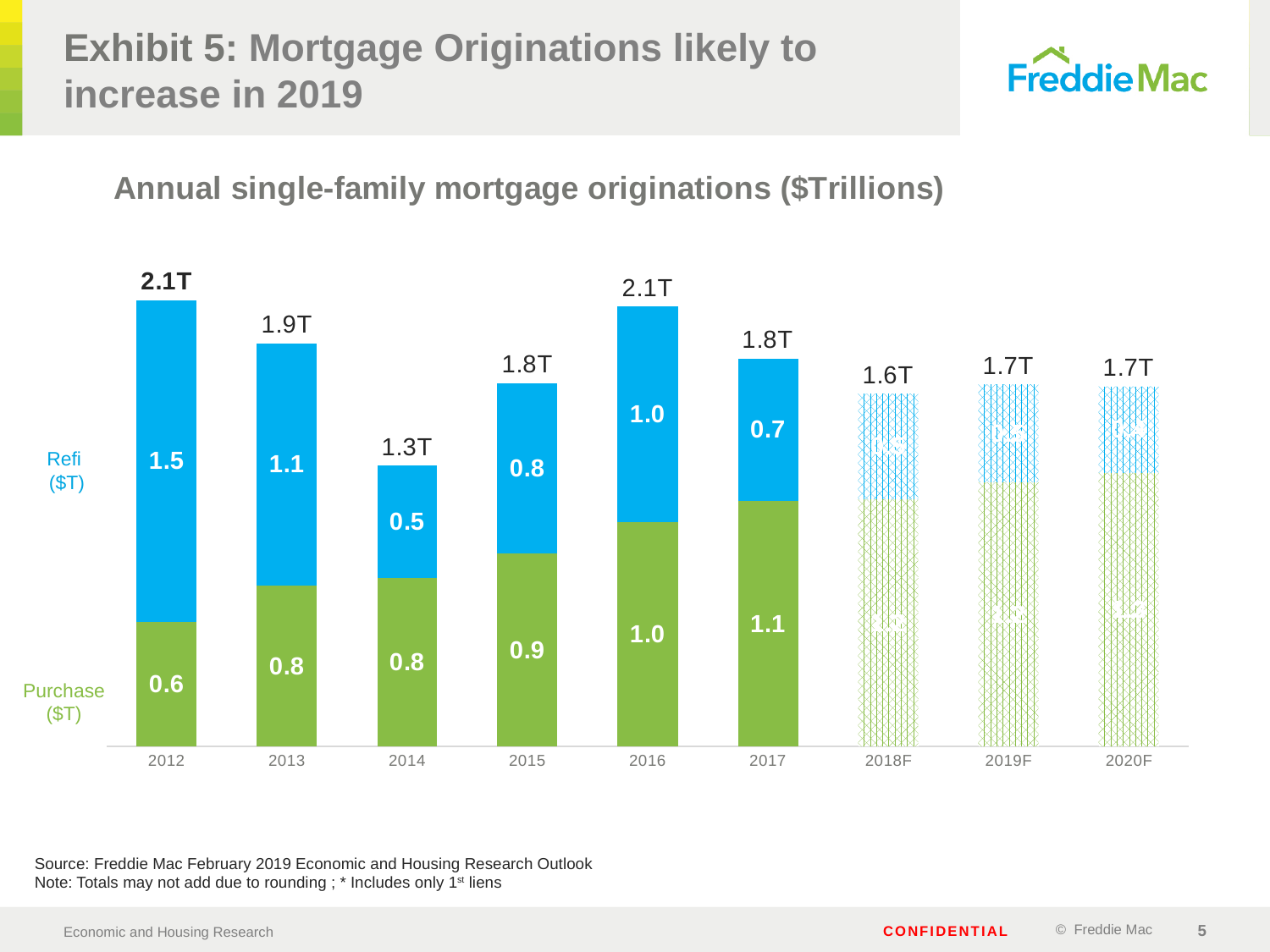
Which year has the highest Refi value? 2012 Which year has the lowest total mortgage originations? 2014 What is the Purchase value for 2017? 1.1 What is the difference between the Purchase value in 2017 and the Purchase value in 2012? 0.5 How many years are shown on the x axis? 9 How many series are stacked in each bar? 2 What is the Refi value for 2014? 0.5 What is the total origination value labeled for 2018F? 1.6T What kind of chart is shown on the slide? Stacked bar chart Does the Purchase value rise or fall from 2012 to 2017? Rise What is the total annual single-family mortgage origination value shown for 2012? 2.1T Is the Refi value larger in 2016 or in 2017? 2016